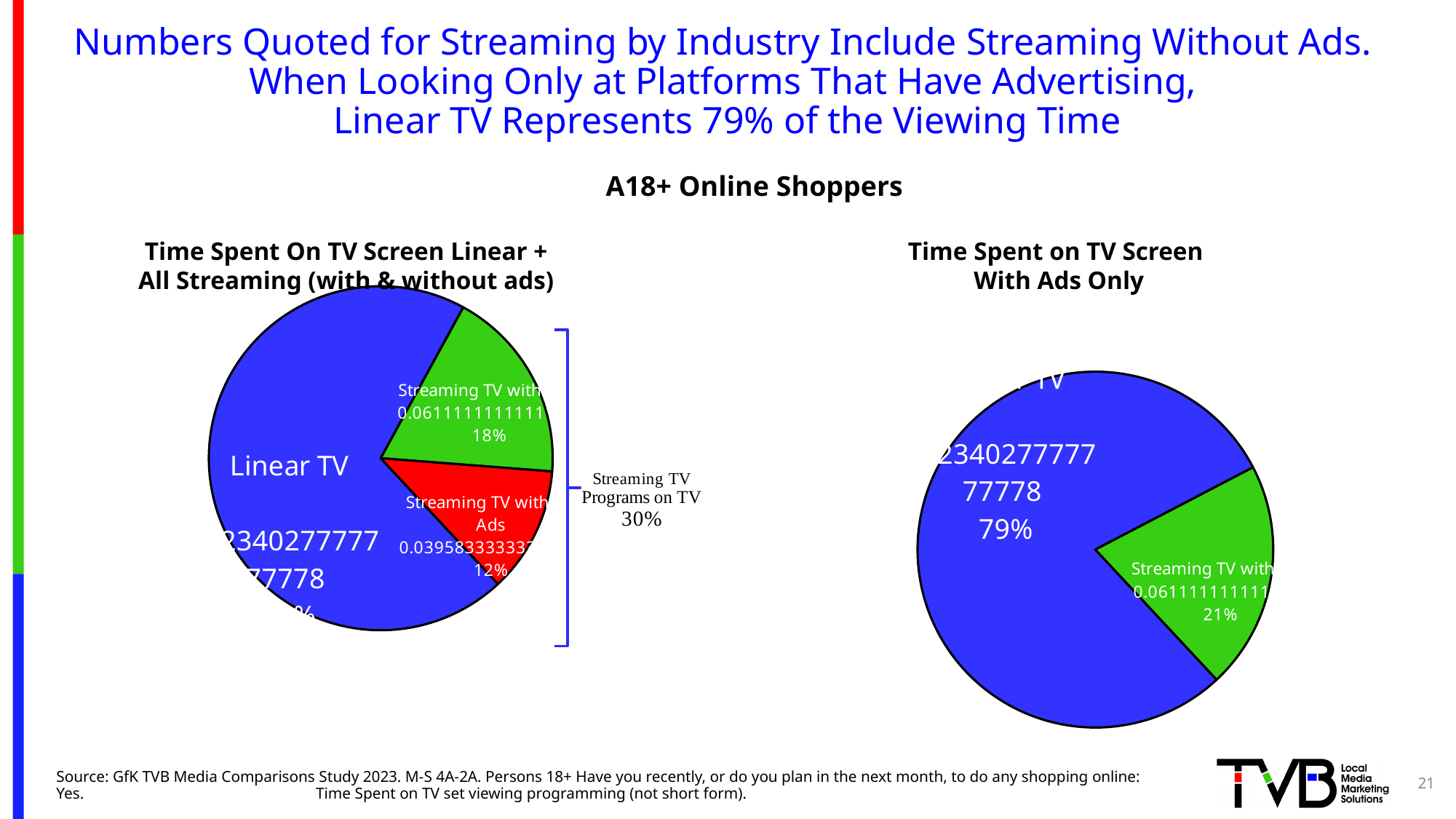
Which audience group is named in the subtitle above the two pie charts? A18+ Online Shoppers In the left pie chart (Linear + All Streaming), what percentage is shown on the green slice? 18% In the right pie chart (With Ads Only), what percentage is shown on the green streaming slice? 21% In the left pie chart (Linear + All Streaming), what combined share is shown by the bracket for Streaming TV Programs on TV? 30% In the right pie chart (With Ads Only), how many slices does the pie have? 2 In the left pie chart (Linear + All Streaming), what is the difference in percentage points between the green slice (18%) and Streaming TV with Ads (12%)? 6 percentage points What type of chart is used on the left, titled "Time Spent On TV Screen Linear + All Streaming (with & without ads)"? pie chart In the left pie chart (Linear + All Streaming), how many slices does the pie have? 3 In the left pie chart (Linear + All Streaming), which slice is the largest? Linear TV In the right pie chart (With Ads Only), what percentage is shown for Linear TV? 79%